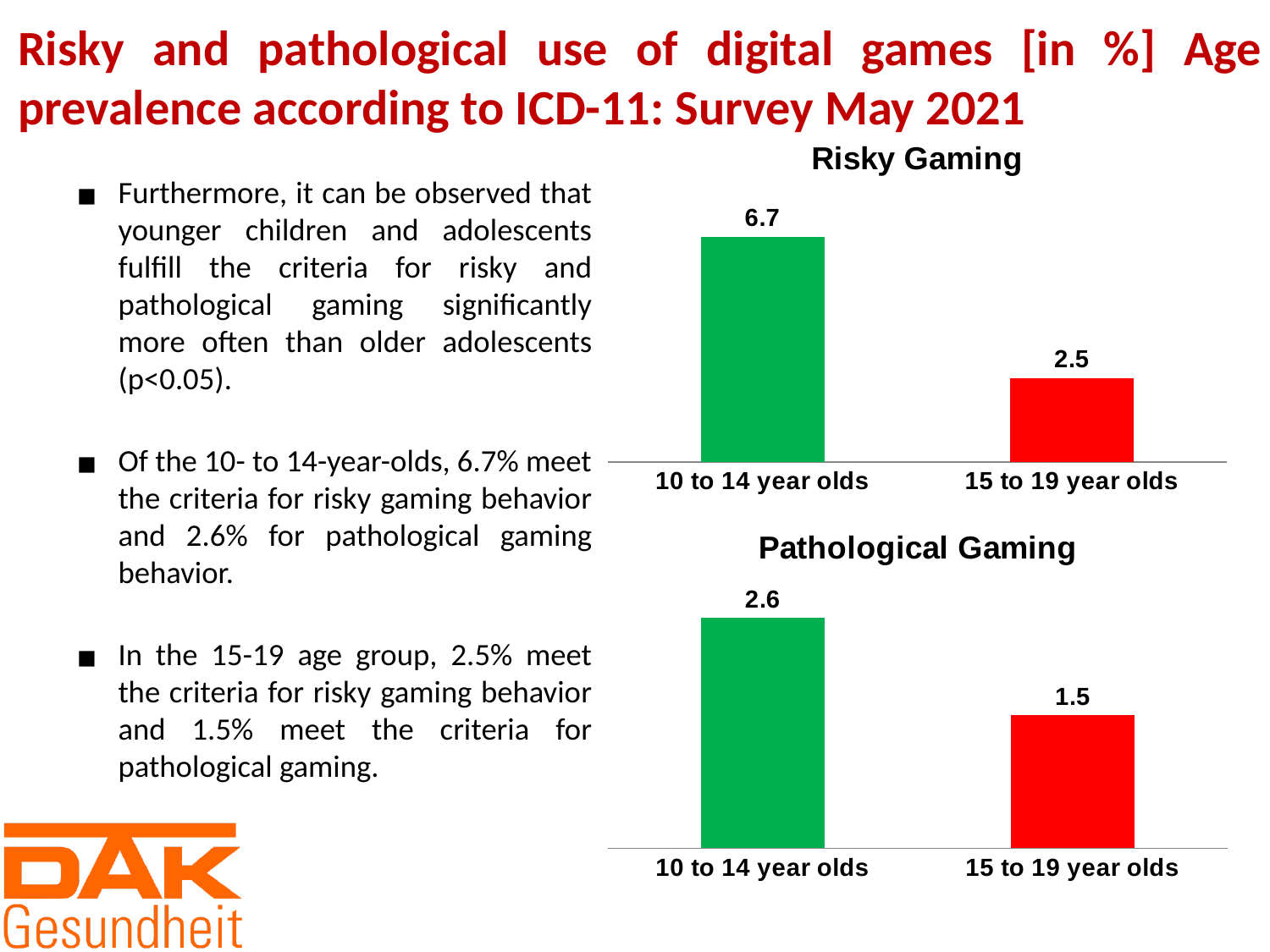
In the Pathological Gaming chart, which is larger: the value for 10 to 14 year olds or for 15 to 19 year olds? 10 to 14 year olds In the Pathological Gaming chart, what is the value for 15 to 19 year olds? 1.5 In the Pathological Gaming chart, what is the difference between the values for 10 to 14 year olds and 15 to 19 year olds? 1.1 In the Risky Gaming chart, what colour is the bar for 15 to 19 year olds? Red In the Risky Gaming chart, what is the difference between the values for 10 to 14 year olds and 15 to 19 year olds? 4.2 How many categories does the Risky Gaming chart show? 2 What type of chart is the Pathological Gaming chart? Bar chart In the Risky Gaming chart, what is the value for 15 to 19 year olds? 2.5 In the Pathological Gaming chart, what is the value for 10 to 14 year olds? 2.6 In the Risky Gaming chart, what is the value for 10 to 14 year olds? 6.7 In the Risky Gaming chart, which age group has the highest value? 10 to 14 year olds In the Pathological Gaming chart, which age group has the lowest value? 15 to 19 year olds